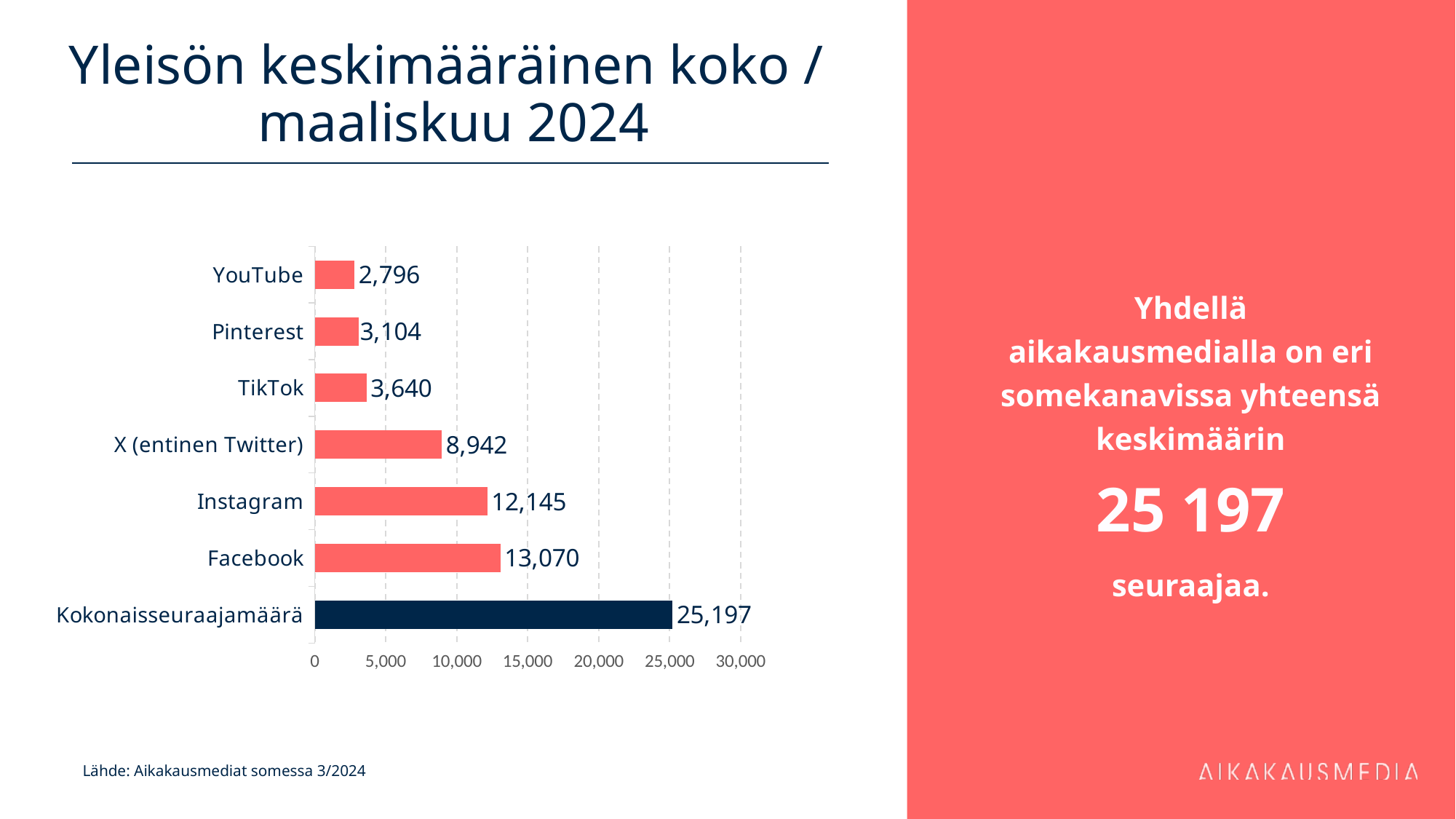
Which category has the lowest value? YouTube Is the value for Instagram greater or less than 10,000? greater Which category has the highest value? Kokonaisseuraajamäärä What is the value for YouTube? 2,796 What is the value for Facebook? 13,070 Which is larger, the value for TikTok or the value for Pinterest? TikTok What kind of chart is shown on the slide? bar chart What is the value for X (entinen Twitter)? 8,942 How many categories are shown in the chart? 7 What is the title of the slide? Yleisön keskimääräinen koko / maaliskuu 2024 What is the difference between the values for Facebook and Instagram? 925 What is the value for Kokonaisseuraajamäärä? 25,197